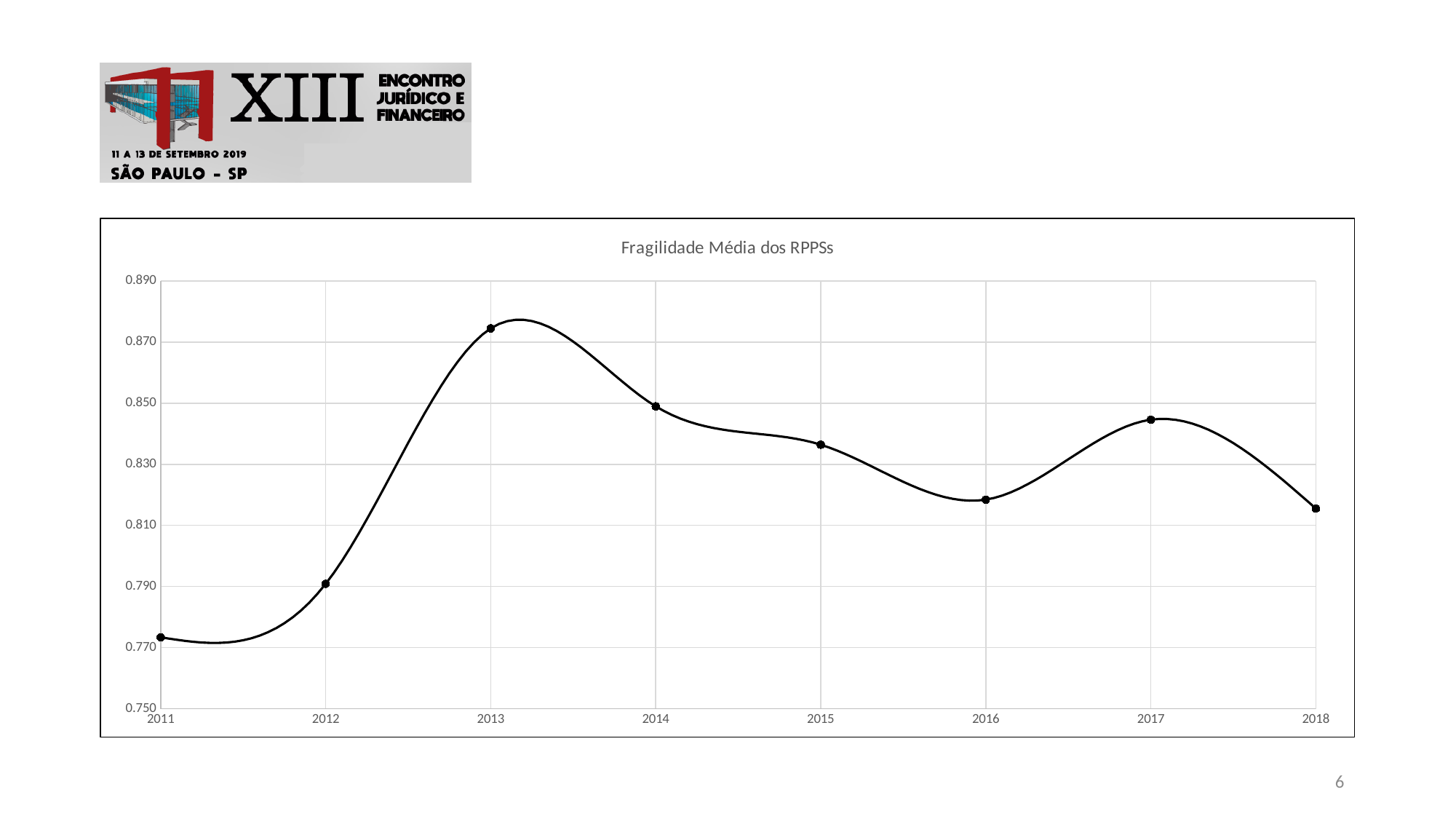
What is the title of the chart? Fragilidade Média dos RPPSs Is the value for 2011 greater or less than 0.790? less How many years are plotted on the x axis of the chart? 8 Is the value for 2016 greater or less than 0.830? less What kind of chart is shown on the slide? Line chart Does the value rise or fall from 2013 to 2016? Fall In which year is the value lowest? 2011 Is the value for 2013 greater or less than 0.870? greater Which year has the larger value, 2012 or 2017? 2017 In which year is the value highest? 2013 Which year has the larger value, 2014 or 2016? 2014